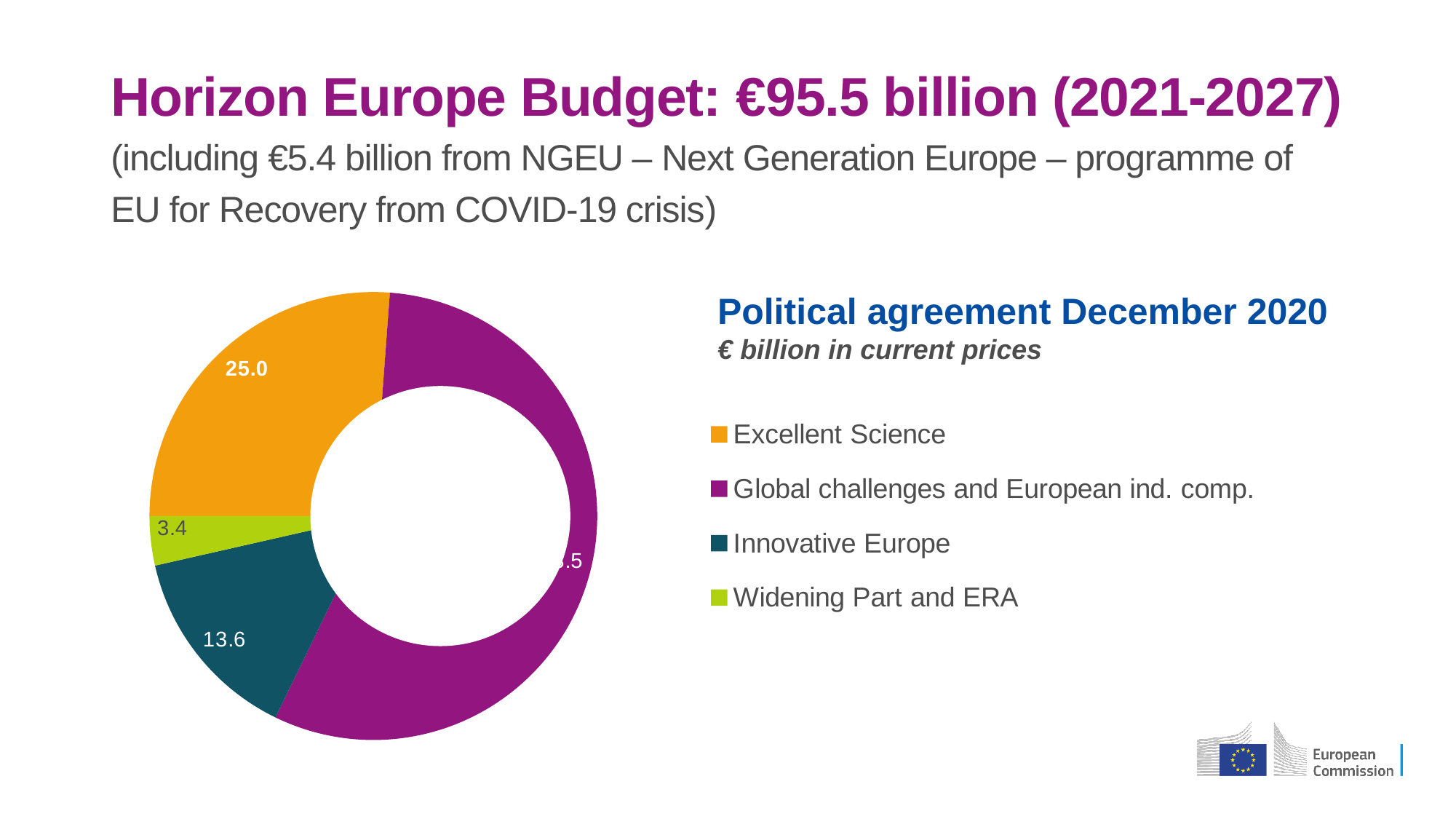
What is the difference between the values for Innovative Europe and Widening Part and ERA? 10.2 How many categories does the chart show? 4 What is the difference between the values for Excellent Science and Widening Part and ERA? 21.6 What colour represents Excellent Science in the chart? orange What kind of chart is shown on the slide? pie chart (doughnut) What is the value for Excellent Science? 25.0 What is the value for Innovative Europe? 13.6 Which category has the smallest slice of the chart? Widening Part and ERA Which category has the largest slice of the chart? Global challenges and European ind. comp. What is the difference between the values for Excellent Science and Innovative Europe? 11.4 What is the value for Widening Part and ERA? 3.4 Which is larger, the value for Excellent Science or the value for Innovative Europe? Excellent Science